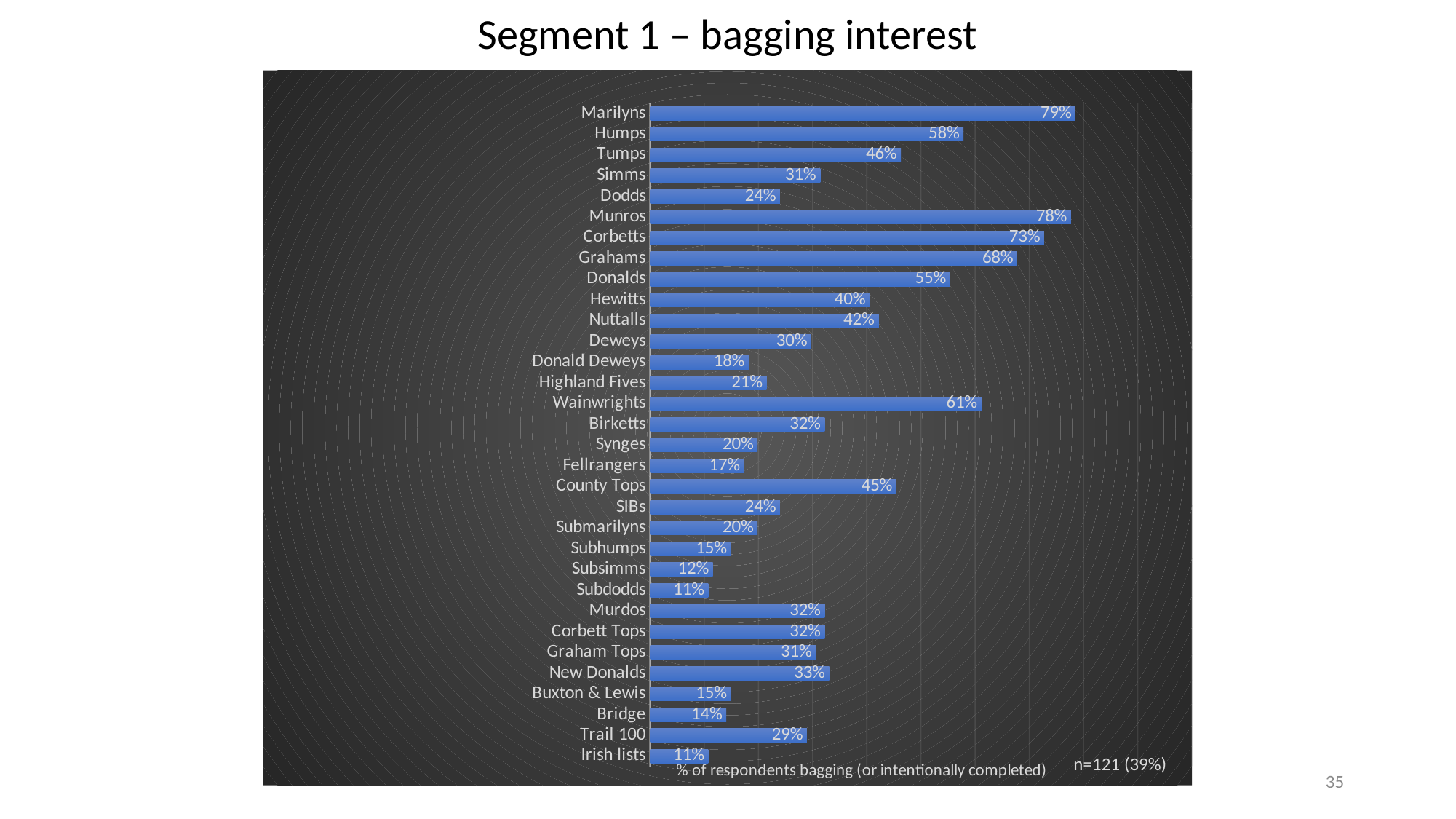
What is the sample size noted on the chart? n=121 (39%) What is the value for Trail 100? 29% What is the value shown for Wainwrights? 61% What kind of chart is shown on the slide? Bar chart What percentage of respondents are bagging Marilyns? 79% Which has a larger value, Hewitts or Nuttalls? Nuttalls What is the difference between the values for Humps and Tumps? 12% Which has a larger value, Grahams or Donalds? Grahams Which list has the highest percentage of respondents bagging it? Marilyns What percentage is shown for County Tops? 45% What is the difference between the values for Munros and Corbetts? 5% How many lists (categories) are shown in the chart? 32